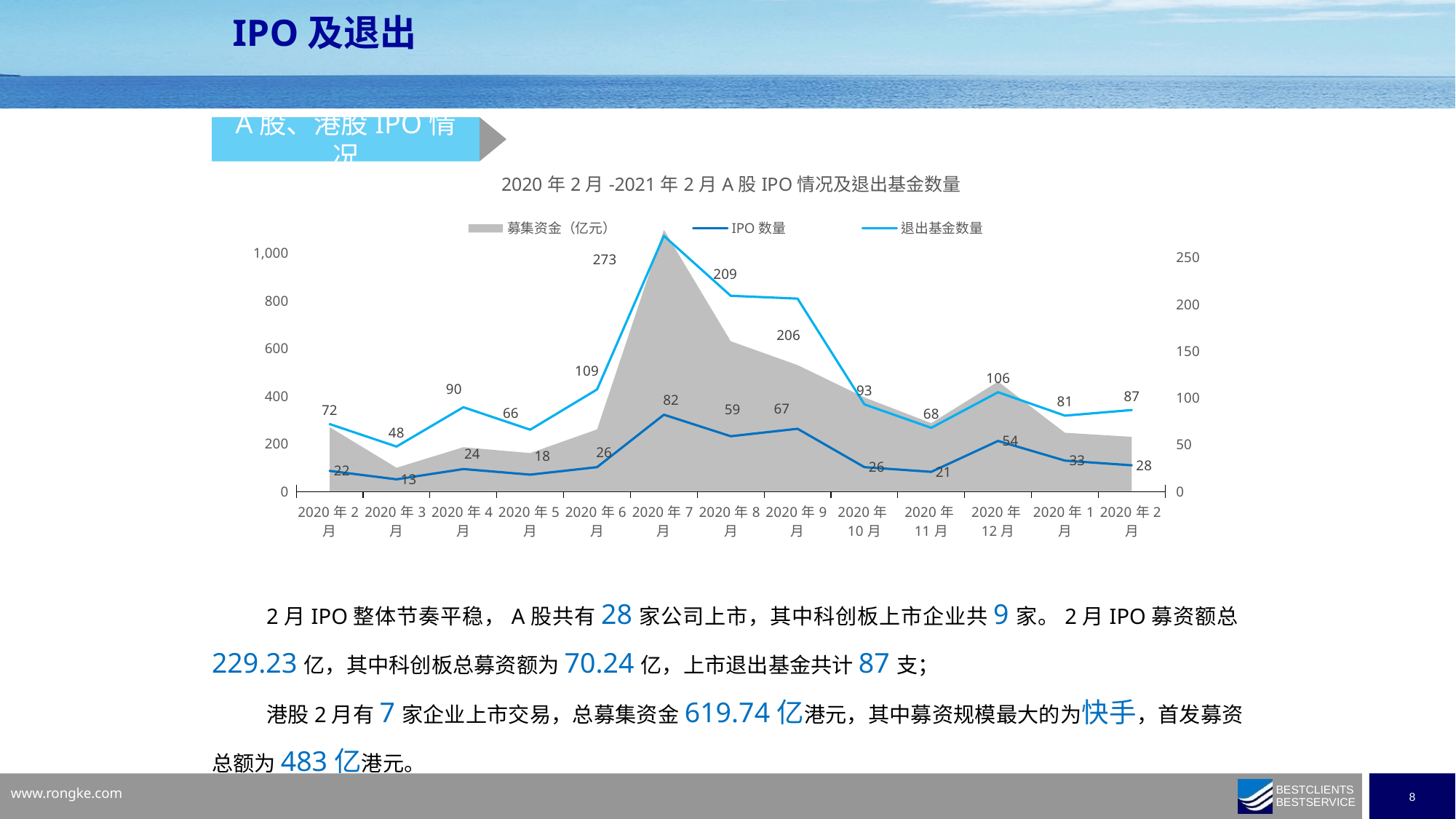
Is the 募集资金（亿元） value for 2020年7月 greater or less than 800? greater How many series does the chart's legend list? 3 Which month has the highest 退出基金数量? 2020年7月 What is the IPO数量 value for 2020年7月? 82 Which month has the larger IPO数量, 2020年8月 or 2020年9月? 2020年9月 What is the 退出基金数量 value for 2020年12月? 106 What is the 退出基金数量 value for 2020年7月? 273 What is the difference between the 退出基金数量 values for 2020年8月 and 2020年9月? 3 How many months are shown on the x axis of the chart? 13 Does the IPO数量 rise or fall from 2020年9月 to 2020年11月? fall What is the IPO数量 value for 2020年2月, the first category on the x axis? 22 Which month has the lowest IPO数量? 2020年3月